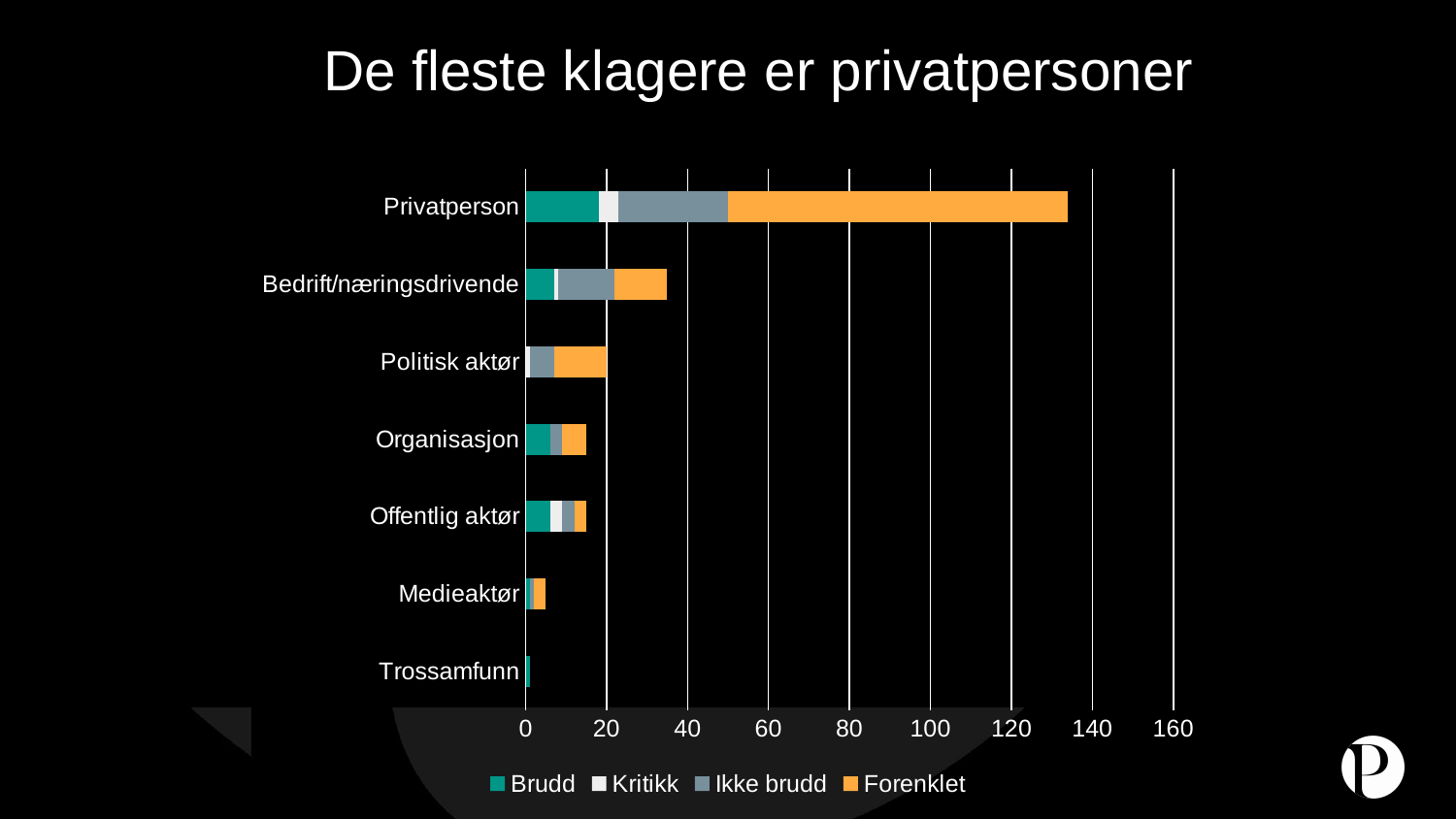
Which category has the shortest total bar? Trossamfunn Which category has the longest total bar? Privatperson What kind of chart is shown on the slide? bar chart How many series does the legend list? 4 Which series is shown in orange in the legend? Forenklet Is the total value for Privatperson greater or less than 140? less Is the total value for Organisasjon greater or less than 20? less Is the total value for Bedrift/næringsdrivende greater or less than 40? less What is the title of the chart? De fleste klagere er privatpersoner Which has a larger total bar, Bedrift/næringsdrivende or Politisk aktør? Bedrift/næringsdrivende How many categories are shown on the chart? 7